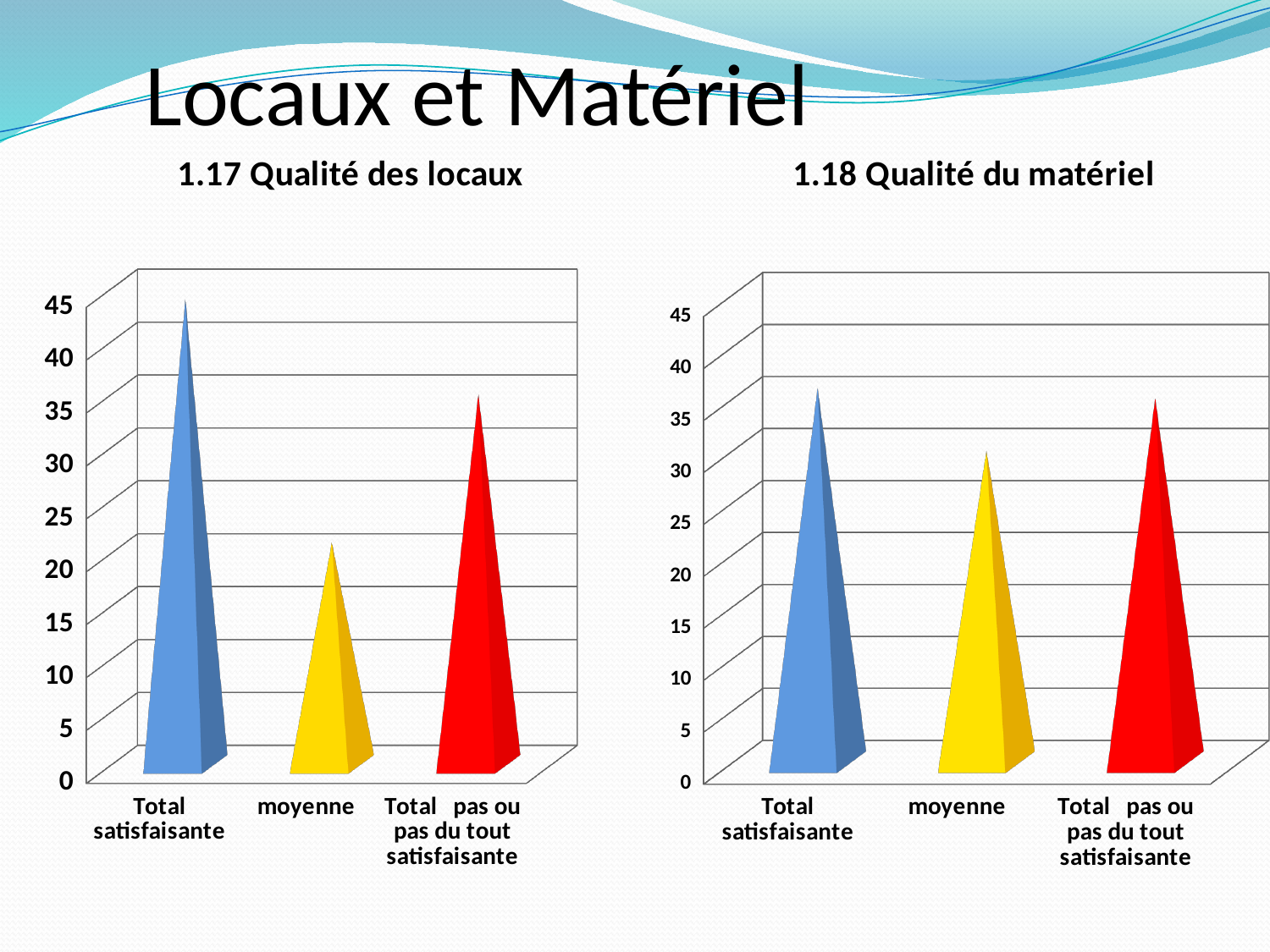
How many categories are shown on the '1.18 Qualité du matériel' chart? 3 What kind of chart is the '1.17 Qualité des locaux' chart? bar chart On the '1.18 Qualité du matériel' chart, which category has the lowest value? moyenne On the '1.17 Qualité des locaux' chart, which is larger: the value for 'moyenne' or the value for 'Total pas ou pas du tout satisfaisante'? Total pas ou pas du tout satisfaisante On the '1.17 Qualité des locaux' chart, is the value for 'Total satisfaisante' greater or less than 40? greater What colour is the bar for 'moyenne' on the '1.18 Qualité du matériel' chart? yellow On the '1.17 Qualité des locaux' chart, which category has the highest value? Total satisfaisante On the '1.17 Qualité des locaux' chart, is the value for 'Total pas ou pas du tout satisfaisante' greater or less than 30? greater On the '1.17 Qualité des locaux' chart, is the value for 'moyenne' greater or less than 25? less On the '1.17 Qualité des locaux' chart, which category has the lowest value? moyenne